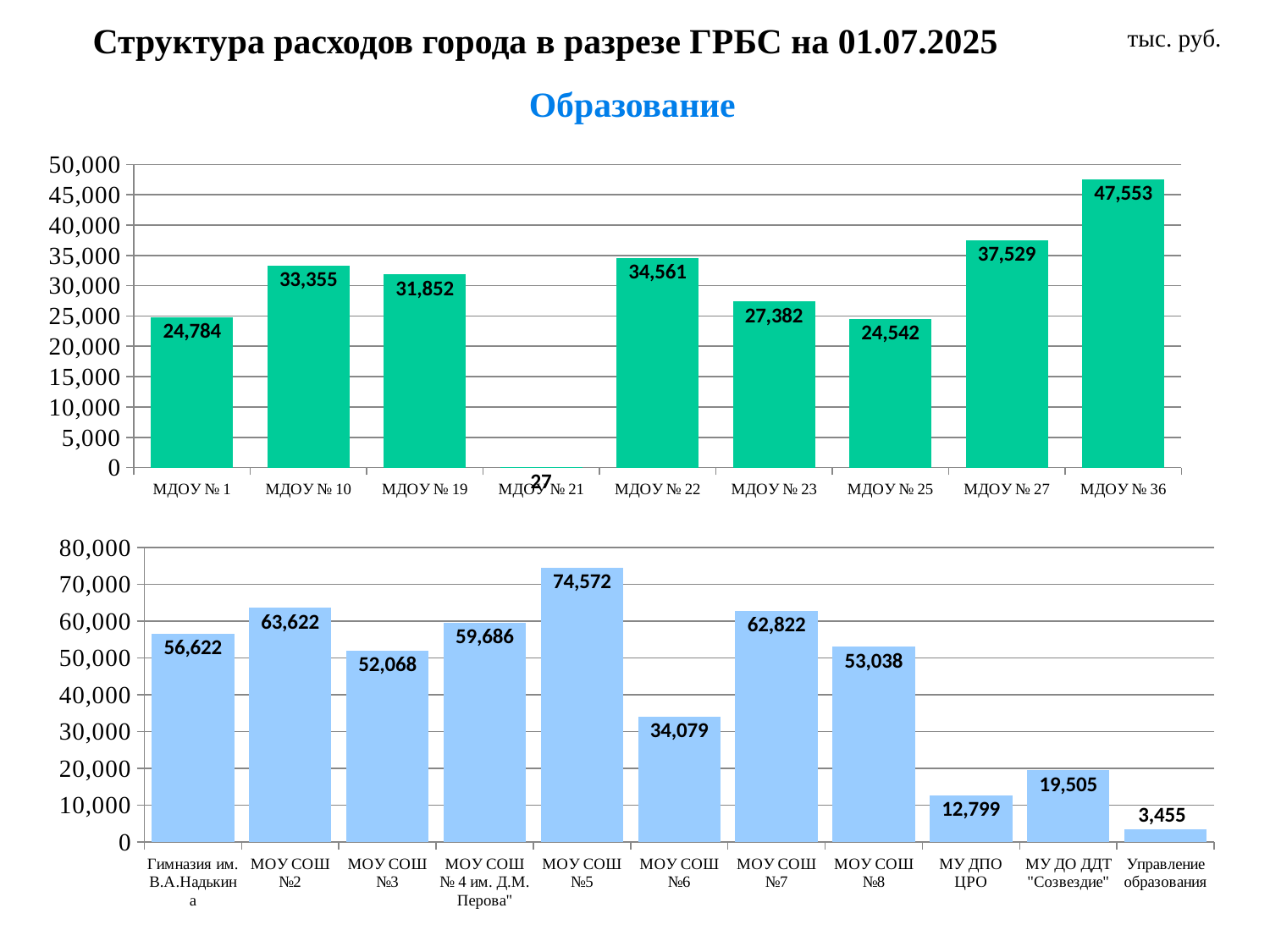
What type of chart is the bottom chart? Bar chart In the top chart (green bars), which is larger: МДОУ № 10 or МДОУ № 19? МДОУ № 10 In the bottom chart (blue bars), how many categories are shown? 11 In the top chart (green bars), what is the value for МДОУ № 36? 47,553 In the bottom chart (blue bars), what is the difference between МОУ СОШ №2 and МОУ СОШ №3? 11,554 In the bottom chart (blue bars), which category has the highest value? МОУ СОШ №5 In the bottom chart (blue bars), which category has the lowest value? Управление образования In the top chart (green bars), how many categories are shown? 9 In the top chart (green bars), what is the difference between МДОУ № 27 and МДОУ № 23? 10,147 In the top chart (green bars), which category has the lowest value? МДОУ № 21 What is the subtitle shown above the charts? Образование In the bottom chart (blue bars), what is the value for МОУ СОШ №5? 74,572